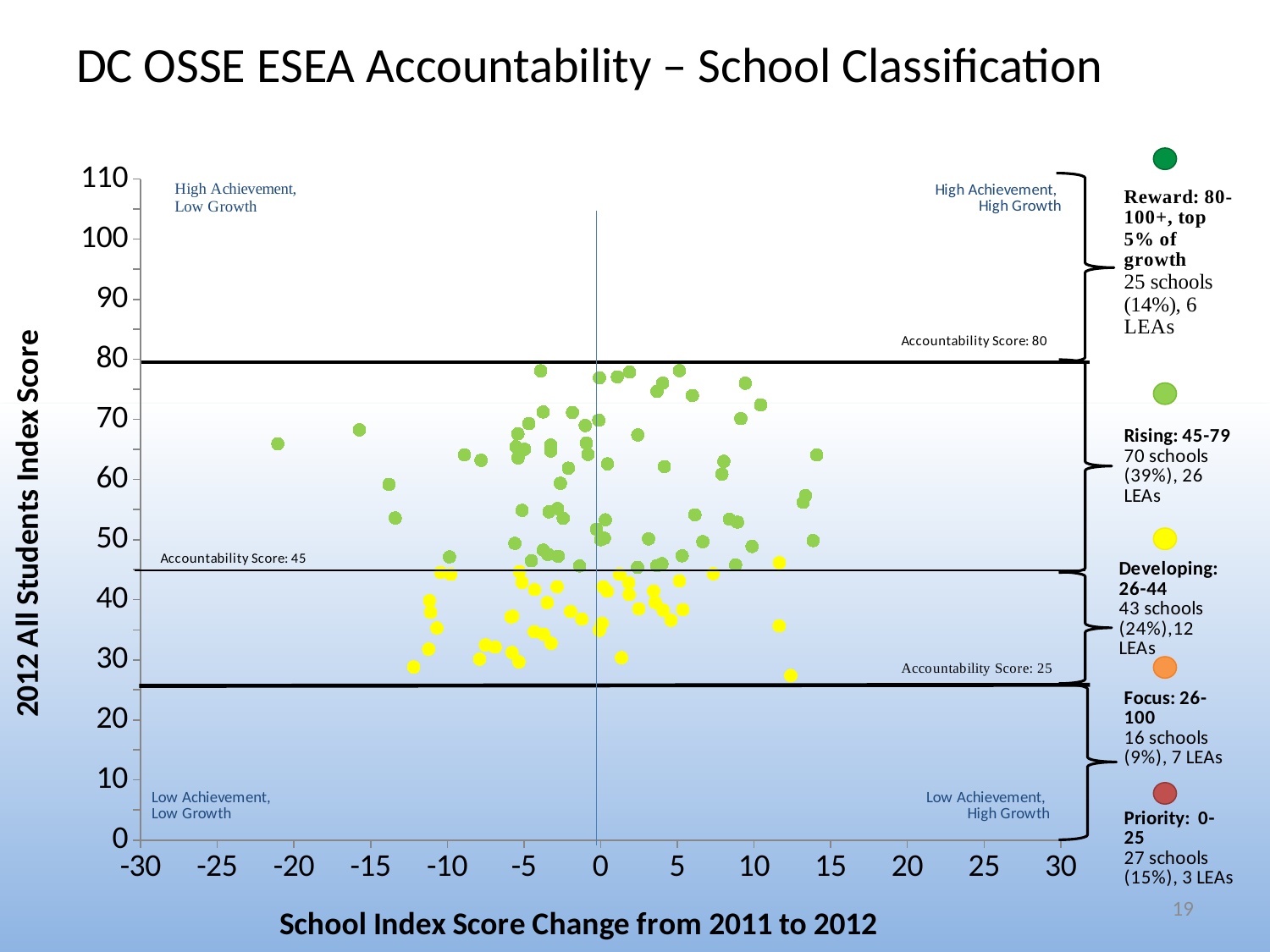
What kind of chart is shown on the slide? Scatter chart How many more schools are in the Rising category than in the Reward category? 45 Are any points plotted above the Accountability Score: 80 line? No At what y value is the middle horizontal accountability score line drawn? 45 What percentage of schools are in the Priority category according to the annotation on the right? 15% At what y value is the lowest horizontal accountability score line drawn? 25 Which classification category has the most schools? Rising What is the title of the y axis of the chart? 2012 All Students Index Score How many schools are in the Rising category according to the annotation on the right? 70 schools Which classification category has the fewest schools? Focus What is the title of the x axis of the chart? School Index Score Change from 2011 to 2012 Which category has more schools, Developing or Priority? Developing